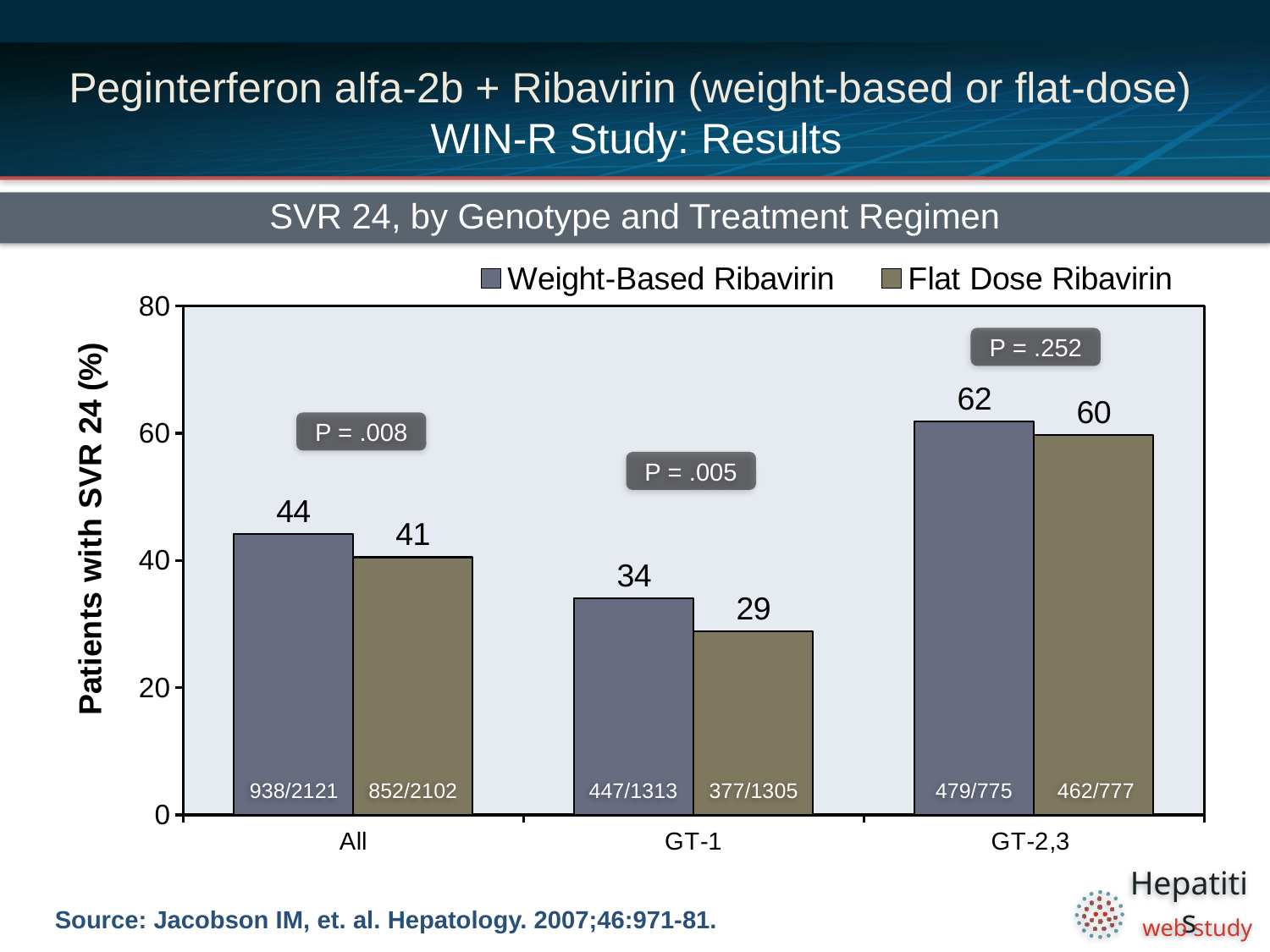
How many series does the legend list? 2 What is the SVR 24 rate for Weight-Based Ribavirin in the All group? 44 What is the difference between the Weight-Based Ribavirin and Flat Dose Ribavirin SVR 24 rates in the GT-1 group? 5 Which genotype group has the lowest SVR 24 rate for Flat Dose Ribavirin? GT-1 What P value is shown for the GT-2,3 group? P = .252 What kind of chart is shown on the slide? Bar chart What is the SVR 24 rate for Flat Dose Ribavirin in the GT-2,3 group? 60 Is the SVR 24 rate for Weight-Based Ribavirin in the GT-2,3 group greater or less than 60? greater How many genotype groups are shown on the x axis? 3 Which genotype group has the highest SVR 24 rate for Weight-Based Ribavirin? GT-2,3 In the All group, which regimen has the higher SVR 24 rate, Weight-Based Ribavirin or Flat Dose Ribavirin? Weight-Based Ribavirin What is the SVR 24 rate for Flat Dose Ribavirin in the GT-1 group? 29